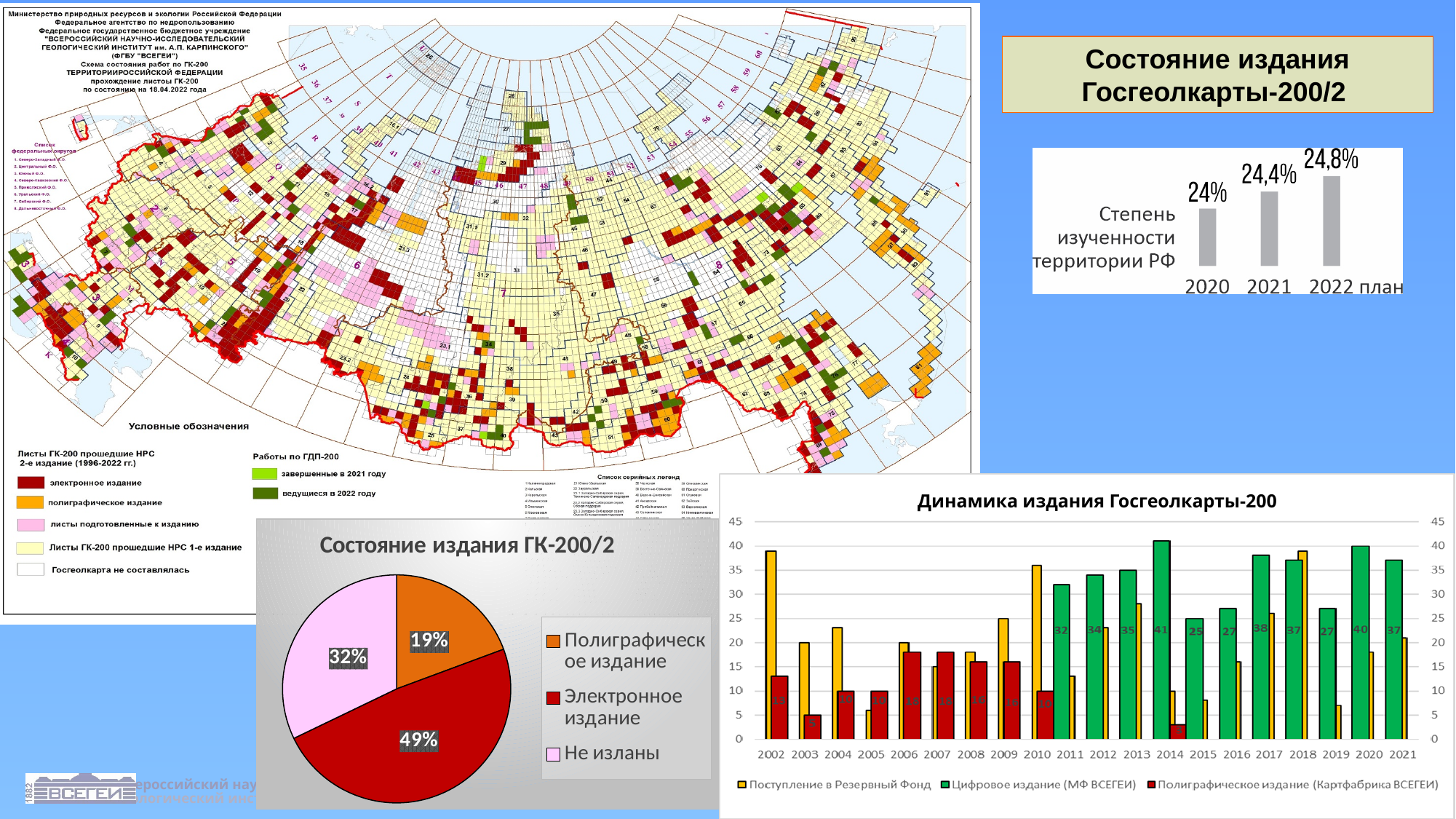
In the pie chart 'Состояние издания ГК-200/2', which category has the smallest slice? Полиграфическое издание In the chart 'Динамика издания Госгеолкарты-200', what is the difference between 'Цифровое издание (МФ ВСЕГЕИ)' in 2020 and in 2015? 15 In the chart 'Динамика издания Госгеолкарты-200', how many series does the legend list? 3 In the pie chart 'Состояние издания ГК-200/2', what share is 'Электронное издание'? 49% In the chart 'Степень изученности территории РФ', what is the value for 2020? 24% In the chart 'Степень изученности территории РФ', what is the value for 2022 план? 24,8% In the chart 'Динамика издания Госгеолкарты-200', which year has the highest value for 'Цифровое издание (МФ ВСЕГЕИ)'? 2014 In the chart 'Динамика издания Госгеолкарты-200', what is the value of 'Полиграфическое издание (Картфабрика ВСЕГЕИ)' for 2003? 5 In the pie chart 'Состояние издания ГК-200/2', what share is 'Не изданы'? 32% In the chart 'Степень изученности территории РФ', do the values rise or fall from 2020 to 2022 план? rise In the pie chart 'Состояние издания ГК-200/2', how many slices are there? 3 In the chart 'Динамика издания Госгеолкарты-200', what is the value of 'Цифровое издание (МФ ВСЕГЕИ)' for 2014? 41